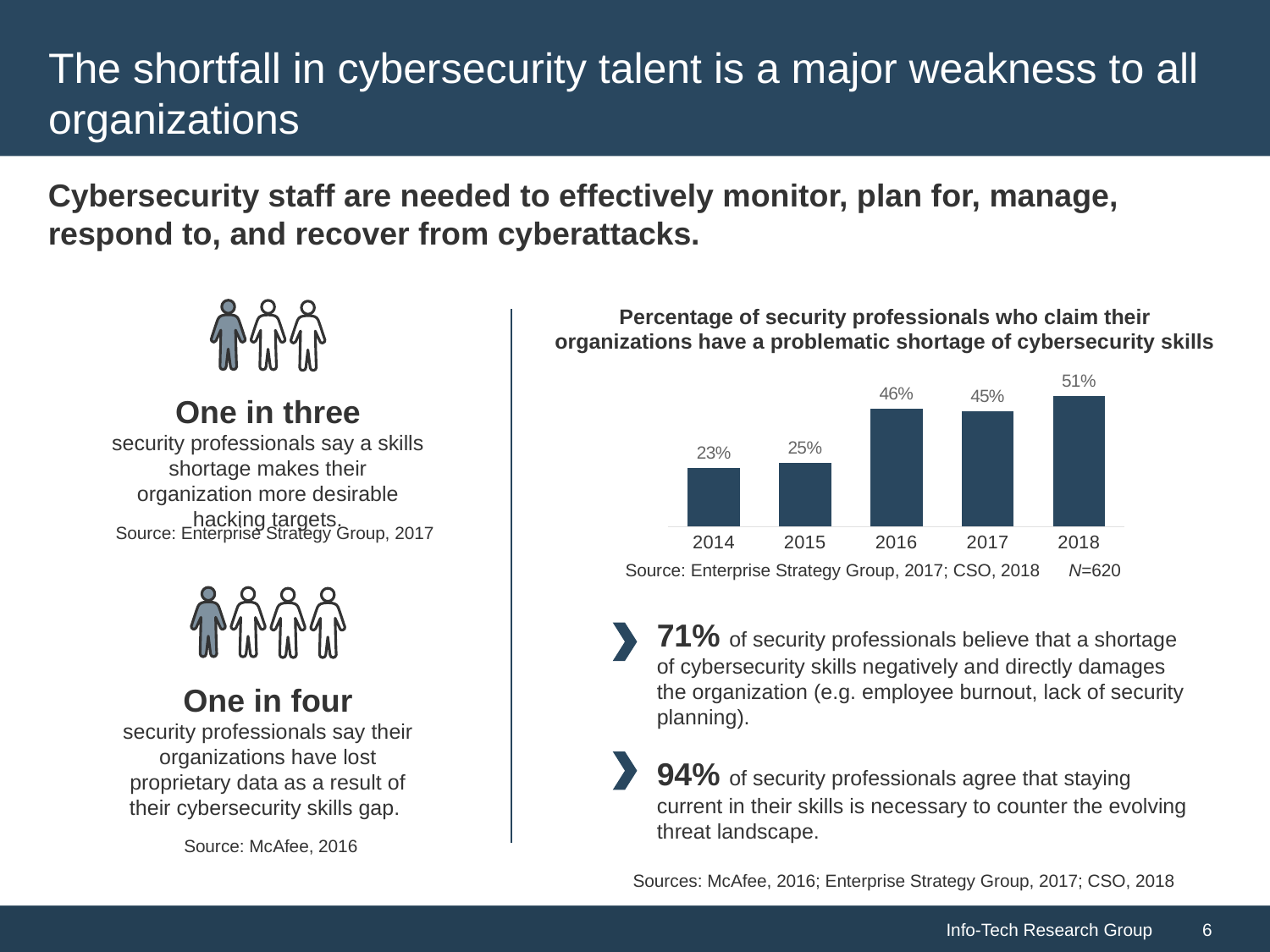
Which year has a larger value, 2016 or 2017? 2016 What is the value shown for 2018 in the chart? 51% What kind of chart is shown on the slide? Bar chart Which year has the lowest percentage in the chart? 2014 How many years are shown in the chart? 5 Which year has the highest percentage in the chart? 2018 What is the difference between the 2016 value and the 2015 value? 21% What is the value shown for 2016 in the chart? 46% What percentage of security professionals claimed a problematic shortage of cybersecurity skills in 2014? 23% What is the difference between the 2018 value and the 2014 value? 28% What is the title of the chart? Percentage of security professionals who claim their organizations have a problematic shortage of cybersecurity skills Do the values generally rise or fall from 2014 to 2018? Rise